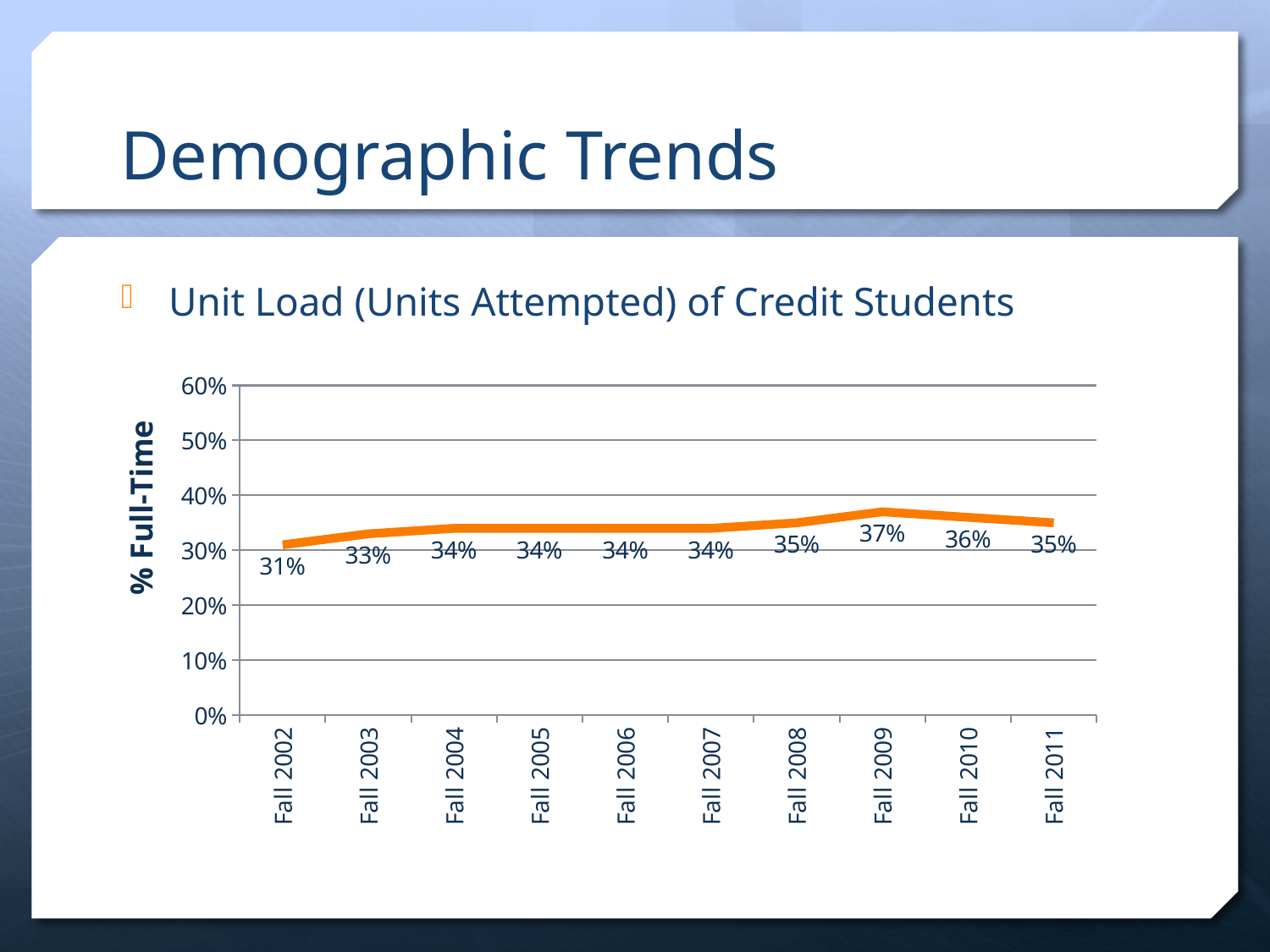
Which term has the lowest % Full-Time value? Fall 2002 What is the % Full-Time value for Fall 2011? 35% How many terms are plotted on the x axis? 10 What kind of chart is shown on the slide? line chart Is the % Full-Time value for Fall 2009 greater or less than 40%? less Which is larger, the % Full-Time value for Fall 2010 or for Fall 2003? Fall 2010 Which term has the highest % Full-Time value? Fall 2009 What is the % Full-Time value for Fall 2002? 31% Does the % Full-Time value rise or fall from Fall 2002 to Fall 2009? rise What is the % Full-Time value for Fall 2009? 37% What is the difference between the % Full-Time values for Fall 2009 and Fall 2002? 6% What is the label on the vertical axis of the chart? % Full-Time